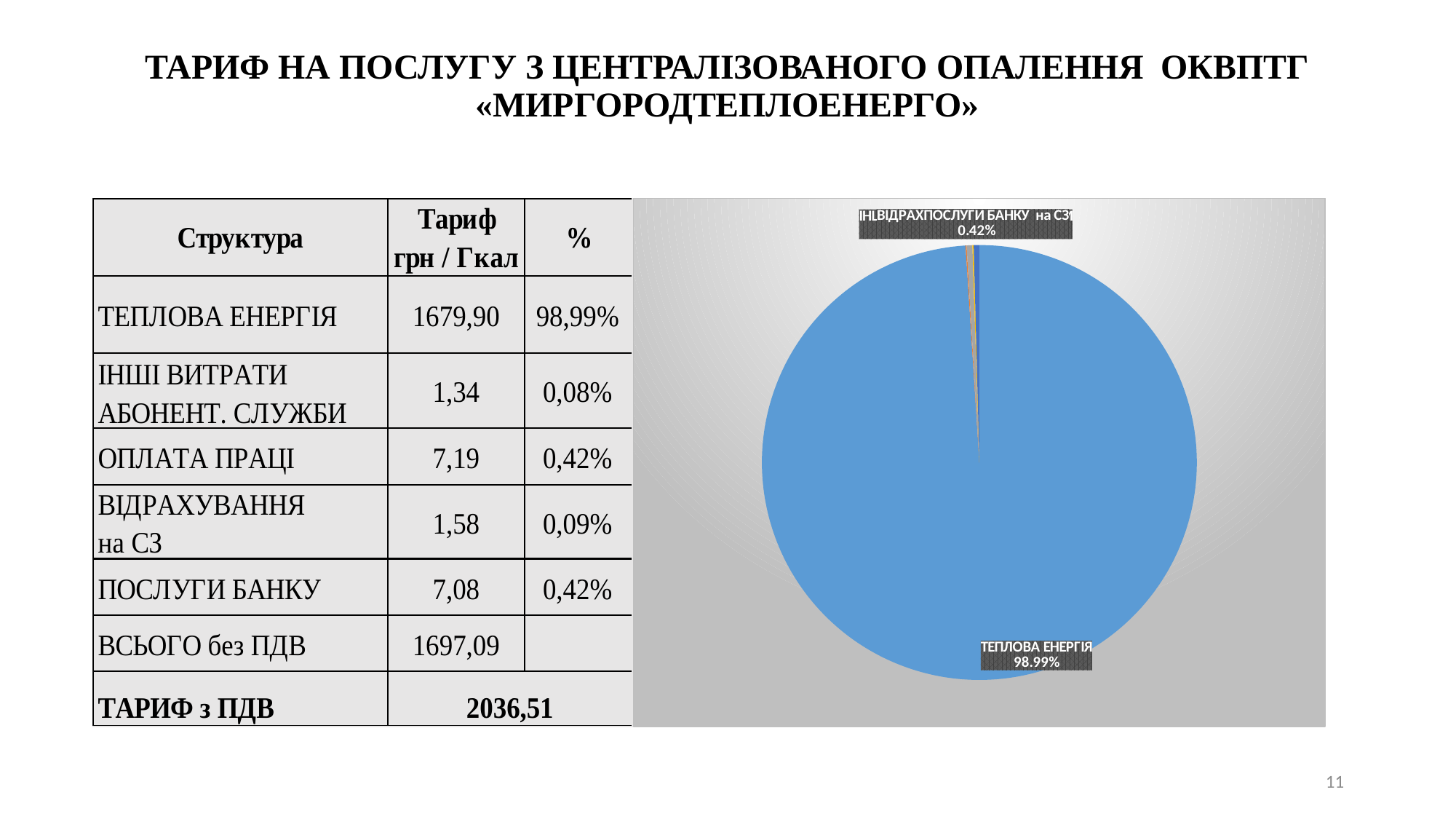
Which category has the largest slice in the pie chart? ТЕПЛОВА ЕНЕРГІЯ What share of the pie does ТЕПЛОВА ЕНЕРГІЯ account for? 98.99% Is the share of ТЕПЛОВА ЕНЕРГІЯ in the pie chart greater or less than 50%? greater What colour is the largest slice of the pie chart? blue What share of the pie does ПОСЛУГИ БАНКУ account for? 0.42% What kind of chart is shown on the slide? pie chart Which slice is larger in the pie chart, ТЕПЛОВА ЕНЕРГІЯ or ПОСЛУГИ БАНКУ? ТЕПЛОВА ЕНЕРГІЯ